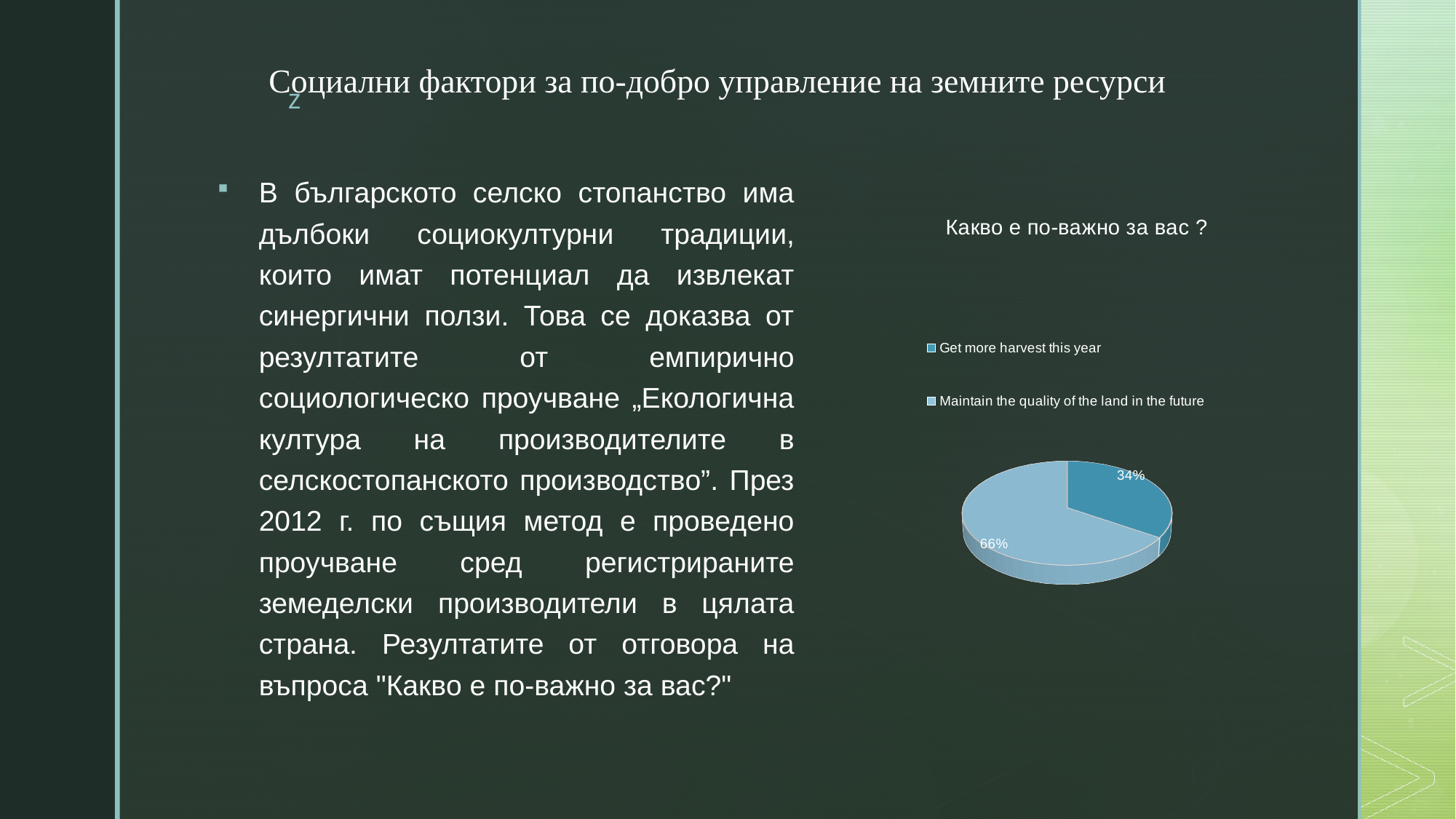
What share of the pie is labelled for "Get more harvest this year"? 34% What kind of chart is shown on the slide? pie chart What share of the pie is labelled for "Maintain the quality of the land in the future"? 66% How many slices does the pie chart have? 2 Which category has the smallest slice of the pie? Get more harvest this year Which legend entry is listed first? Get more harvest this year Is the share for "Get more harvest this year" greater or less than 50%? less Which category has the largest slice of the pie? Maintain the quality of the land in the future What is the title of the chart? Какво е по-важно за вас ? Which is larger: the share for "Get more harvest this year" or for "Maintain the quality of the land in the future"? Maintain the quality of the land in the future How many categories does the legend list? 2 What is the difference in percentage points between the two slices? 32%